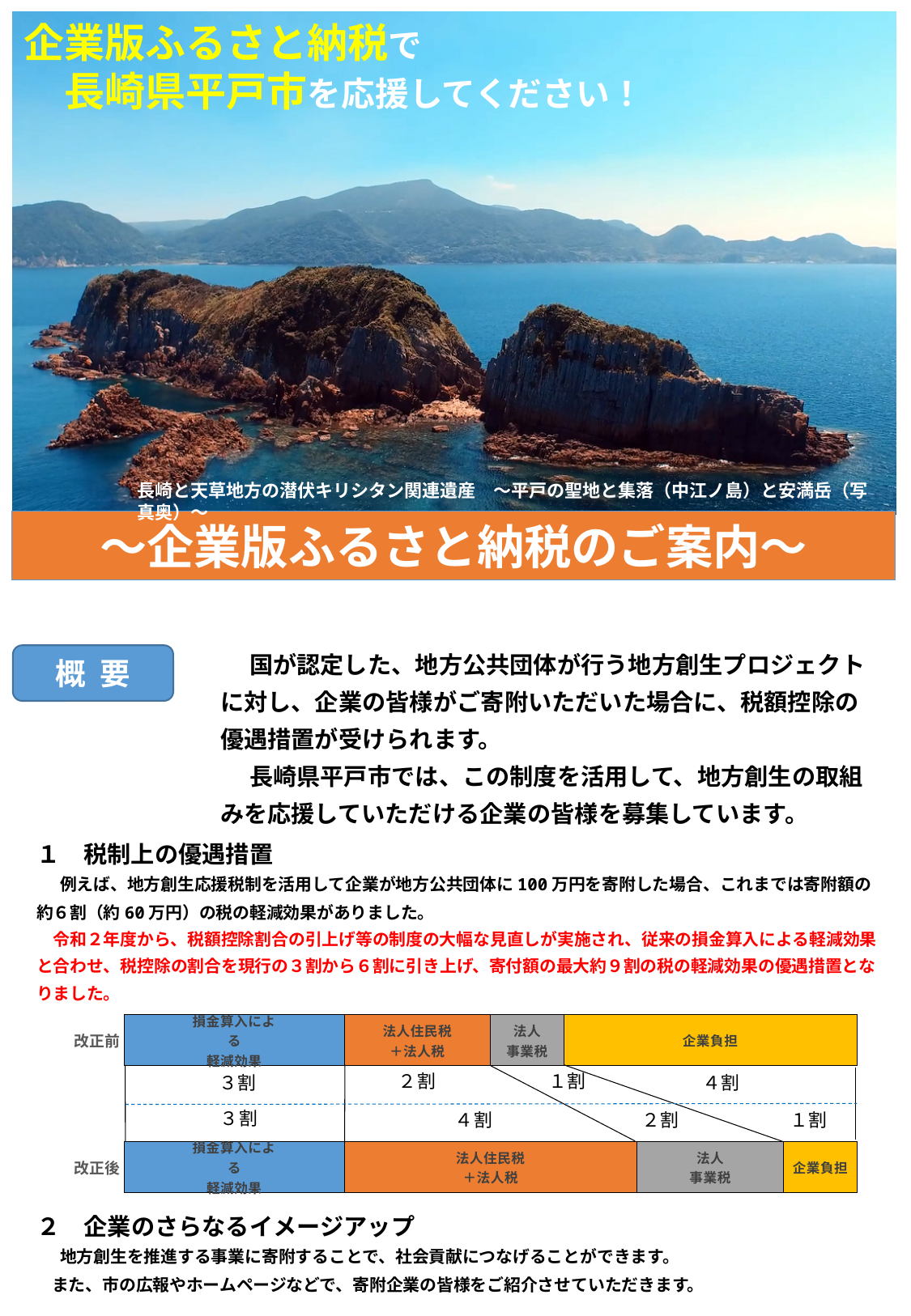
How many segments make up each of the 改正前 and 改正後 bars? 4 In the 改正後 (after revision) bar, what share is labelled for 企業負担? 1割 Which is larger: the 法人住民税＋法人税 share in 改正前 or in 改正後? 改正後 In the 改正後 (after revision) bar, what share is labelled for 法人事業税? 2割 Which segment is the smallest in the 改正後 (after revision) bar? 企業負担 What kind of chart is used to show the 改正前 and 改正後 breakdown? Stacked bar chart In the 改正前 (before revision) bar, what share is labelled for 企業負担? 4割 In the 改正後 (after revision) bar, what share is labelled for 法人住民税＋法人税? 4割 In the 改正前 (before revision) bar, what share is labelled for 損金算入による軽減効果? 3割 By how much does the 企業負担 share fall from 改正前 to 改正後? 3割 What colour is the 企業負担 segment in the bars? Yellow Which segment is the largest in the 改正前 (before revision) bar? 企業負担